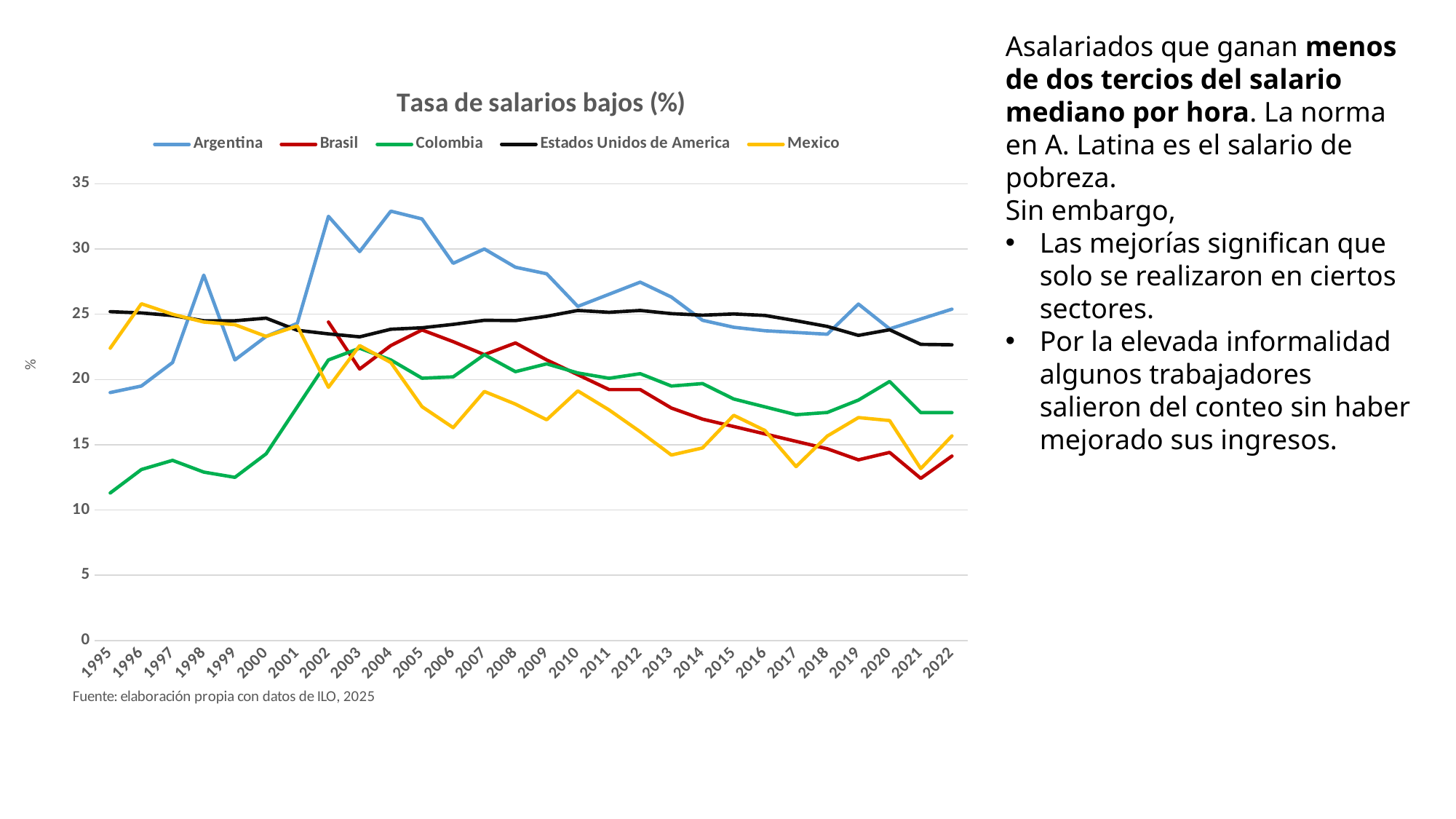
Is the value for Argentina in 2002 greater or less than 30? greater How many series does the legend list? 5 Is the value for Estados Unidos de America in 2022 greater or less than 25? less Which series has the highest value in 2004? Argentina Which series has the lowest value in 1995? Colombia What kind of chart is shown on the slide? Line chart What is the title of the chart? Tasa de salarios bajos (%) Is the value for Colombia in 1995 greater or less than 15? less In 2022, which is higher: Colombia or Brasil? Colombia Which colour is used for the Mexico line? Yellow Does the Brasil line generally rise or fall from 2005 to 2021? Fall How many years are shown along the x axis? 28